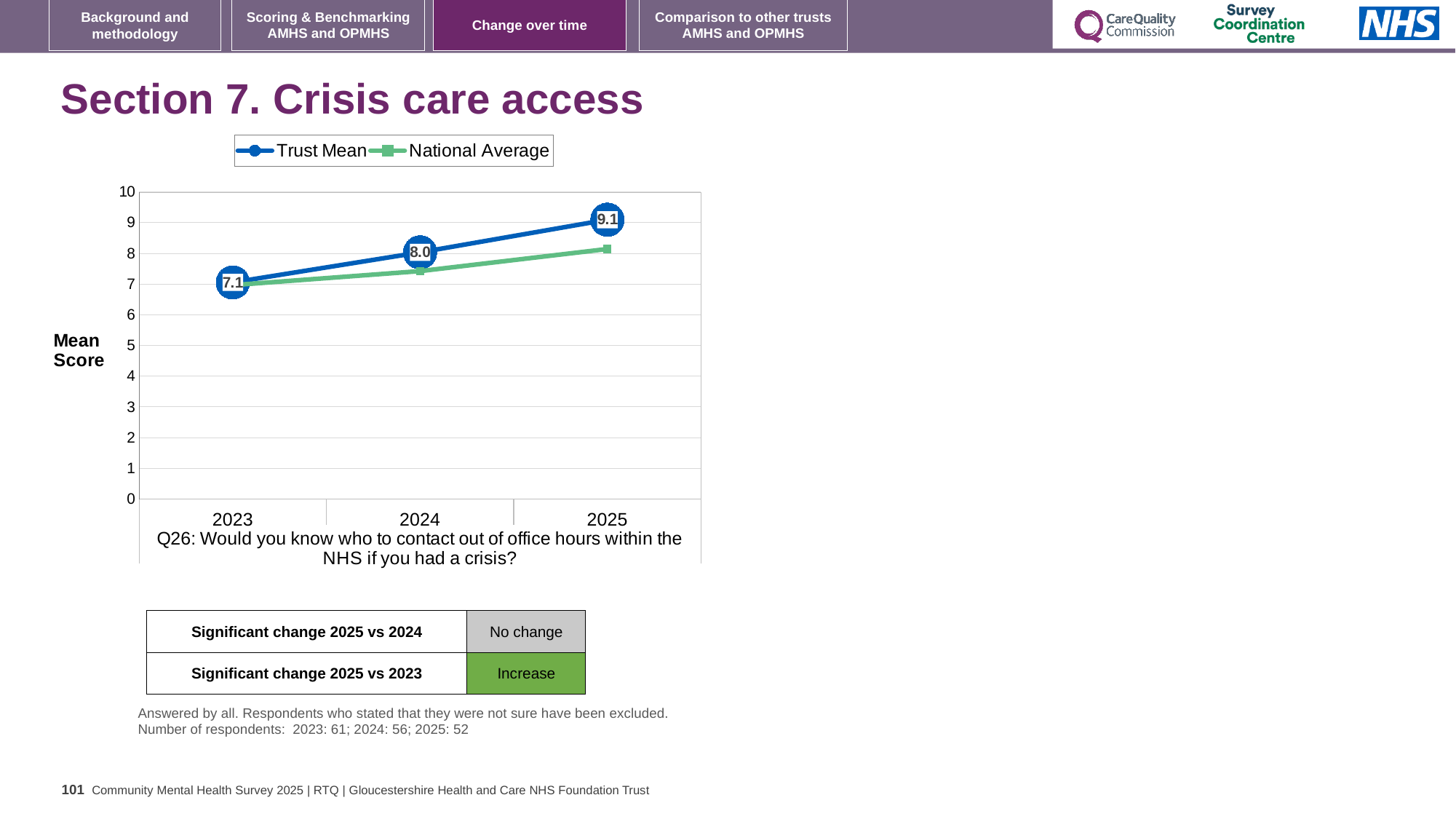
What kind of chart is shown? line chart How many years are shown on the x axis? 3 In which year is the Trust Mean highest? 2025 Is the National Average for 2025 greater or less than 9? less In which year is the Trust Mean lowest? 2023 Which is larger, the Trust Mean in 2024 or the Trust Mean in 2025? 2025 What is the Trust Mean score for 2023? 7.1 What is the difference between the Trust Mean in 2025 and in 2023? 2.0 What is the Trust Mean score for 2024? 8.0 How many series does the legend list? 2 What is the Trust Mean score for 2025? 9.1 Is the National Average for 2024 greater or less than 7? greater